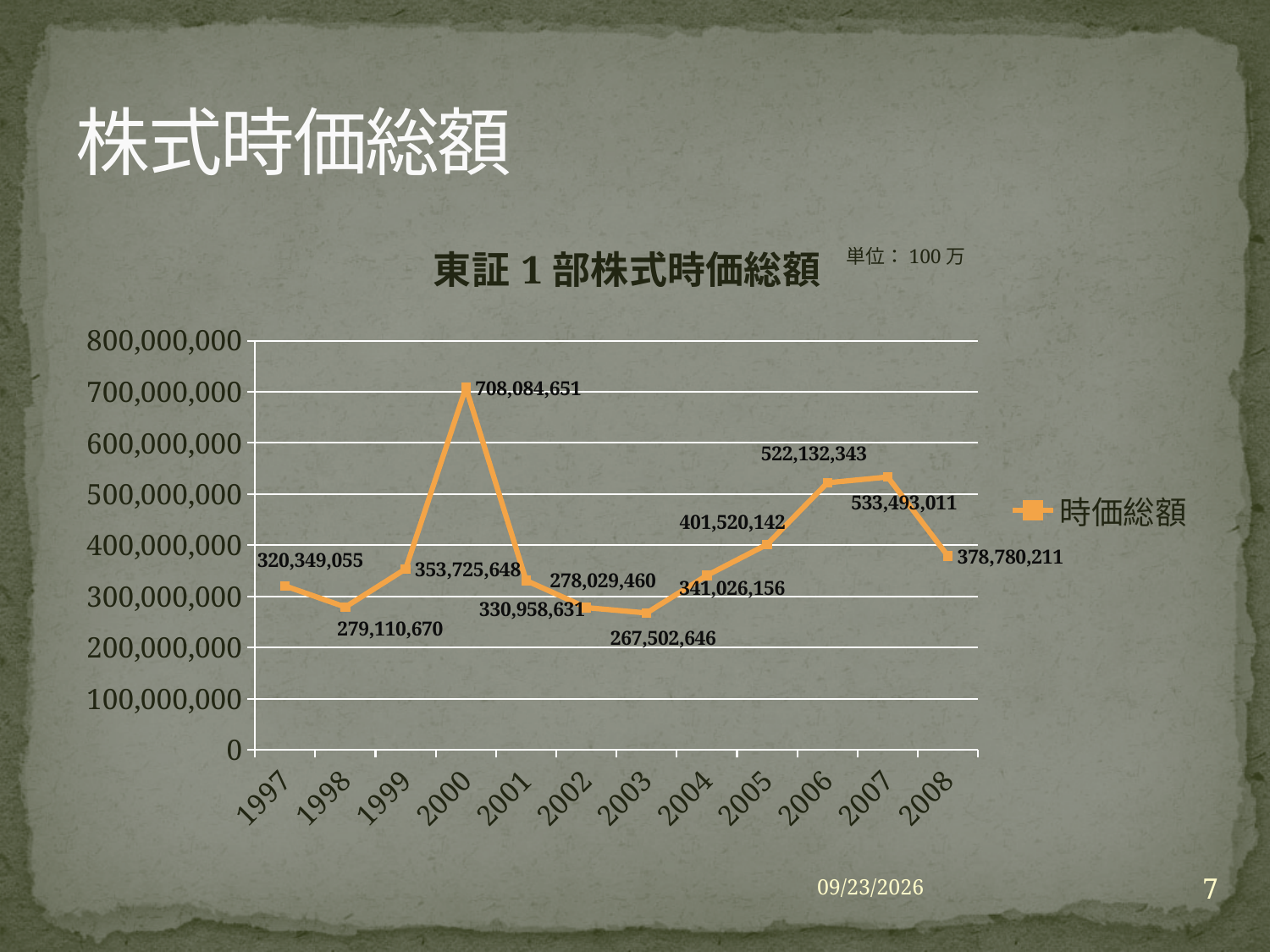
What is the value for 2000 in the 東証１部株式時価総額 chart? 708,084,651 How many series does the legend list? 1 Which is larger, the value for 2005 or the value for 2004? 2005 Is the value for 2006 greater or less than 500,000,000? greater What kind of chart is shown on the slide? line chart Which year has the lowest value in the chart? 2003 What is the difference between the values for 2007 and 2006? 11,360,668 Which year has the highest value in the chart? 2000 How many years are plotted on the x axis of the chart? 12 What is the value for 2008 in the chart? 378,780,211 What is the difference between the values for 2000 and 1997? 387,735,596 What is the value for 2003 in the chart? 267,502,646